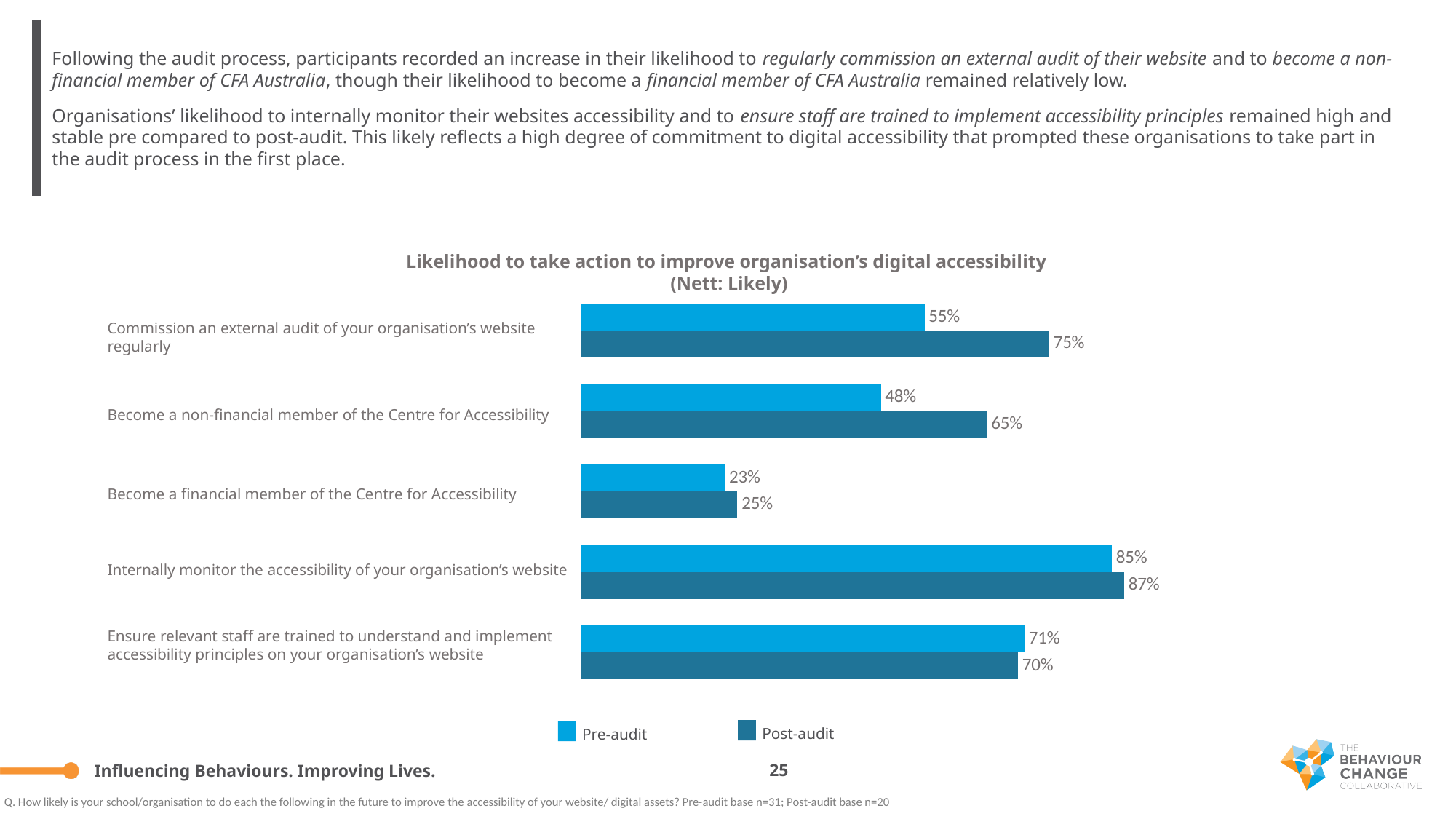
Which category has the highest Post-audit value? Internally monitor the accessibility of your organisation's website What is the difference between the Post-audit and Pre-audit values for 'Become a non-financial member of the Centre for Accessibility'? 17% What is the Pre-audit value for 'Commission an external audit of your organisation's website regularly'? 55% For 'Ensure relevant staff are trained to understand and implement accessibility principles on your organisation's website', which is larger: the Pre-audit or Post-audit value? Pre-audit What is the difference between the Post-audit and Pre-audit values for 'Commission an external audit of your organisation's website regularly'? 20% What type of chart is shown on the slide? Bar chart What is the Post-audit value for 'Become a financial member of the Centre for Accessibility'? 25% What is the Post-audit value for 'Become a non-financial member of the Centre for Accessibility'? 65% Which category has the lowest Pre-audit value? Become a financial member of the Centre for Accessibility How many series does the legend list? 2 What is the title of the chart? Likelihood to take action to improve organisation's digital accessibility (Nett: Likely) How many categories are shown in the chart? 5